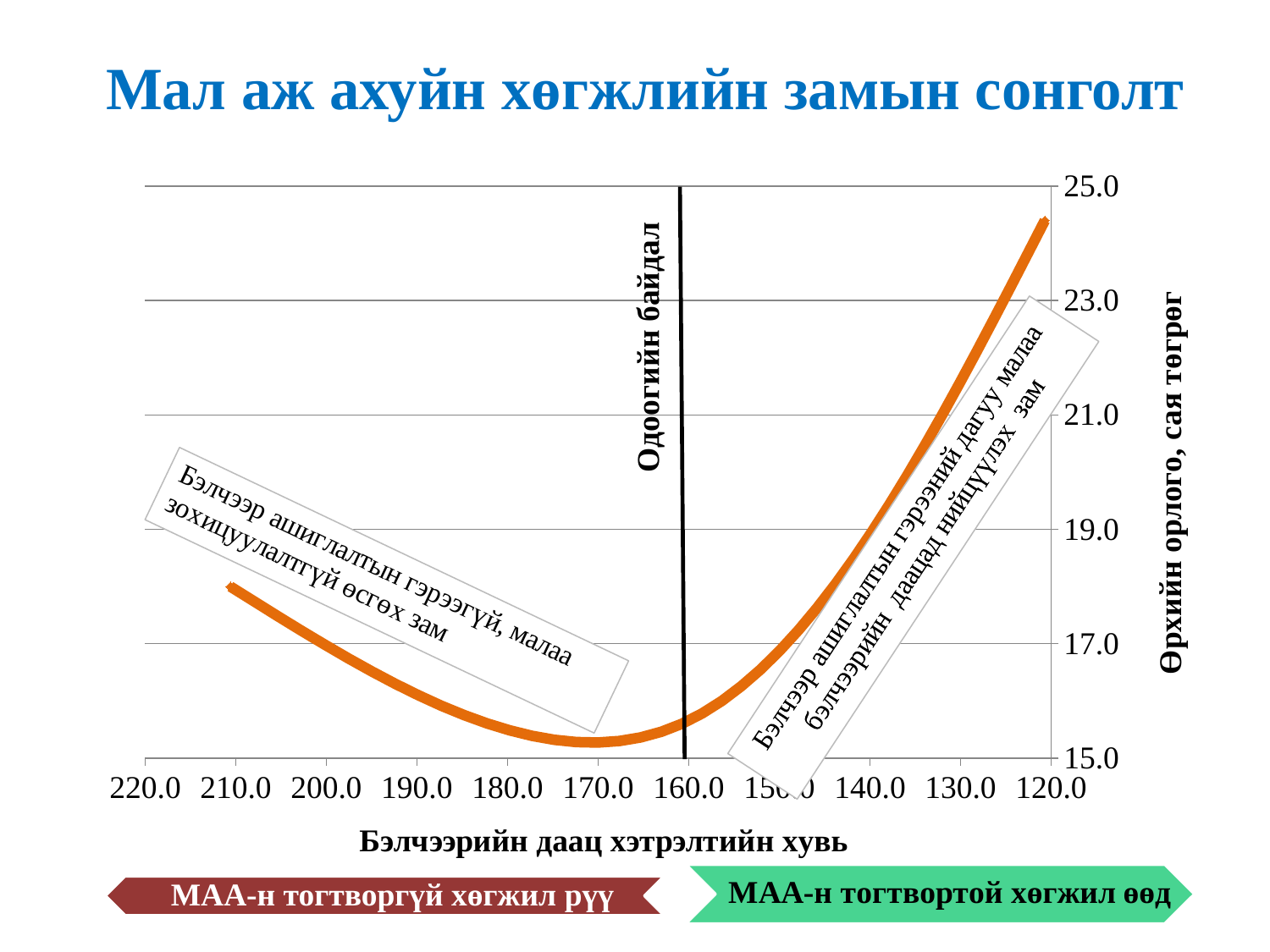
What kind of chart is shown on the slide? line chart Is the value of the curve at 210.0 on the x axis greater or less than 19.0? less Is the value of the curve at 140.0 on the x axis greater or less than 21.0? less Does the curve rise or fall as the x axis goes from 220.0 to 170.0? fall What is the highest value shown on the vertical axis? 25.0 Is the value of the curve at 120.0 on the x axis greater or less than 23.0? greater What is the label of the vertical axis? Өрхийн орлого, сая төгрөг Does the curve rise or fall as the x axis goes from 170.0 to 120.0? rise How many tick labels are shown on the x axis? 11 What is the title of the slide? Мал аж ахуйн хөгжлийн замын сонголт